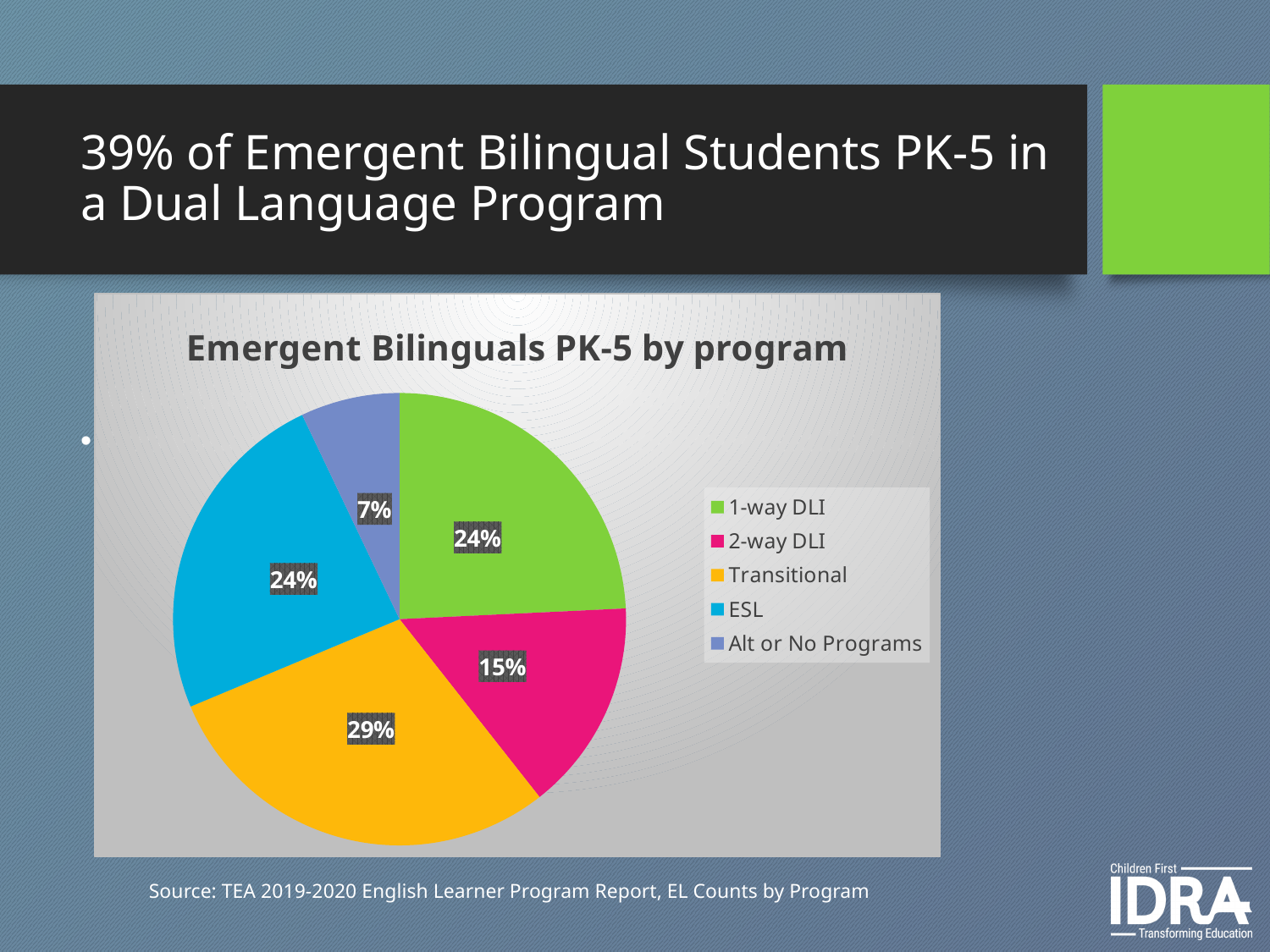
What colour is the ESL slice in the pie chart? Blue Which is larger, the share for 1-way DLI or the share for 2-way DLI? 1-way DLI What is the difference between the Transitional share and the 2-way DLI share? 14% What share of the pie does Transitional represent? 29% What is the title of the chart? Emergent Bilinguals PK-5 by program How many categories does the pie chart show? 5 Which program has the largest share of the pie? Transitional Which program has the smallest share of the pie? Alt or No Programs What kind of chart is shown on the slide? Pie chart What share of the pie does Alt or No Programs represent? 7% What share of the pie does 2-way DLI represent? 15%